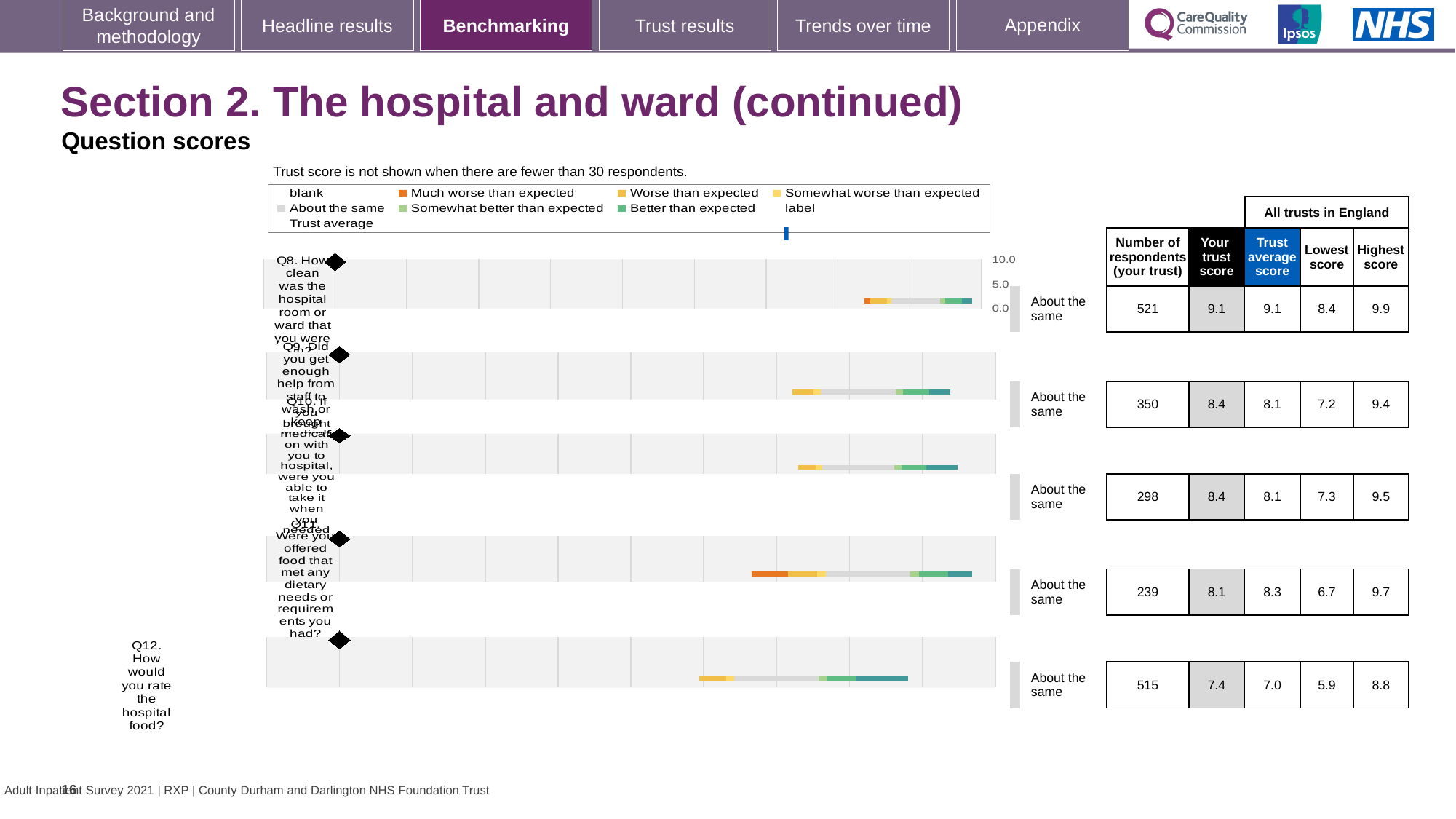
What is your trust score for Q12 (How would you rate the hospital food)? 7.4 Which question has the lowest 'Your trust score' on this slide? Q12 What is the lowest score across all trusts in England for Q12? 5.9 What is the highest score across all trusts in England for Q11 (Were you offered food that met any dietary needs or requirements you had)? 9.7 For Q11, which is larger: your trust score or the trust average score? Trust average score Which question has the largest number of respondents from your trust? Q8 What benchmark category is shown for every question on this slide? About the same For Q8, what is the difference between the highest score and the lowest score across all trusts in England? 1.5 How many respondents from your trust answered Q8 (How clean was the hospital room or ward that you were in)? 521 How many questions are plotted on this slide? 5 What kind of chart is used to show the question scores? Bar chart For Q12, what is the difference between your trust score and the trust average score? 0.4